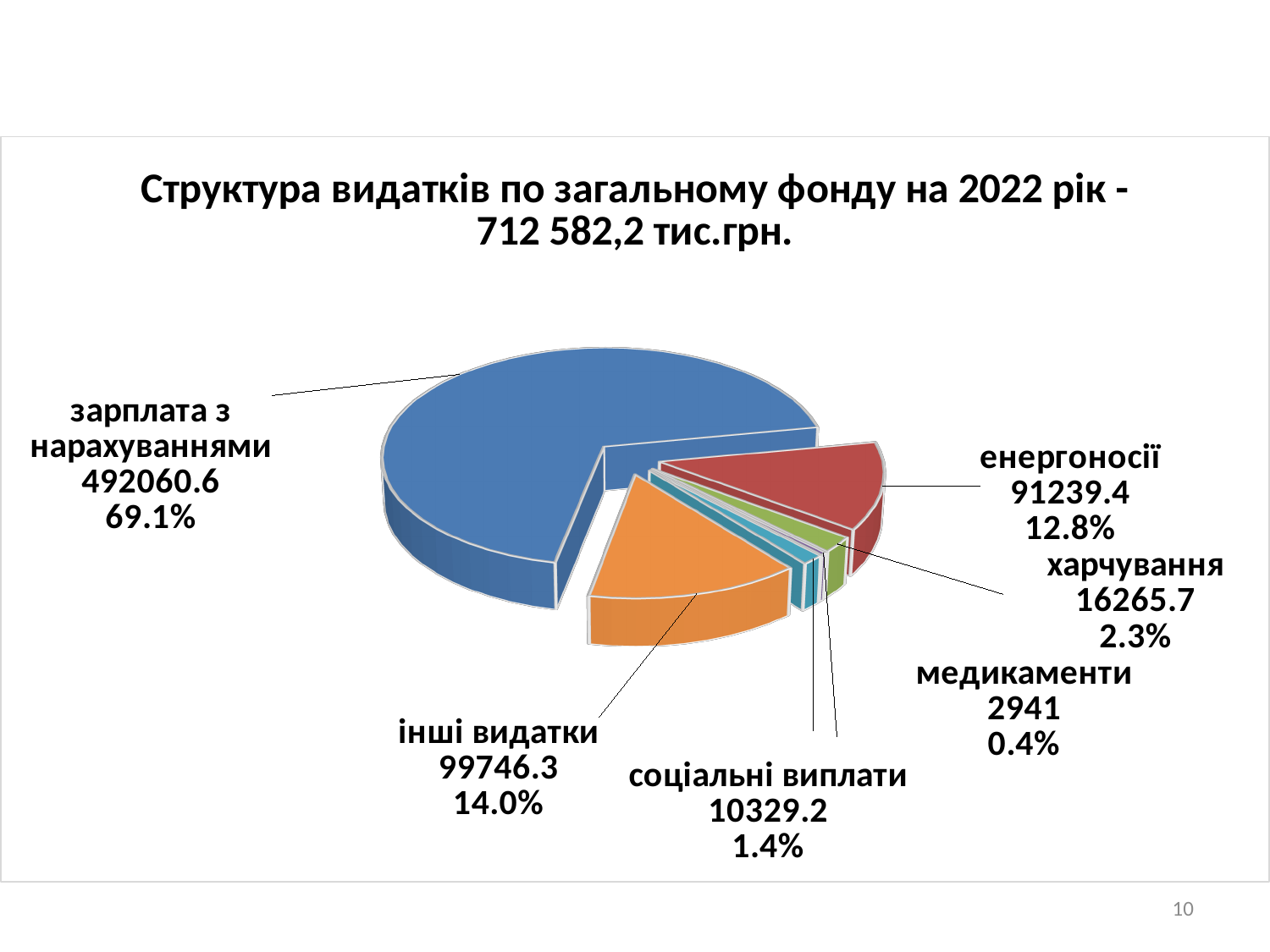
What is the value for медикаменти? 2941 What is the difference between the values for інші видатки and енергоносії? 8506.9 Which is larger, харчування or соціальні виплати? харчування What kind of chart is shown on the slide? pie chart Which category has the smallest slice? медикаменти What total amount is stated in the chart title? 712 582,2 тис.грн. What share of the pie does інші видатки represent? 14.0% How many categories are shown in the pie chart? 6 Which category has the largest slice? зарплата з нарахуваннями What is the value for зарплата з нарахуваннями? 492060.6 What is the difference between the values for харчування and соціальні виплати? 5936.5 What share of the pie does енергоносії represent? 12.8%